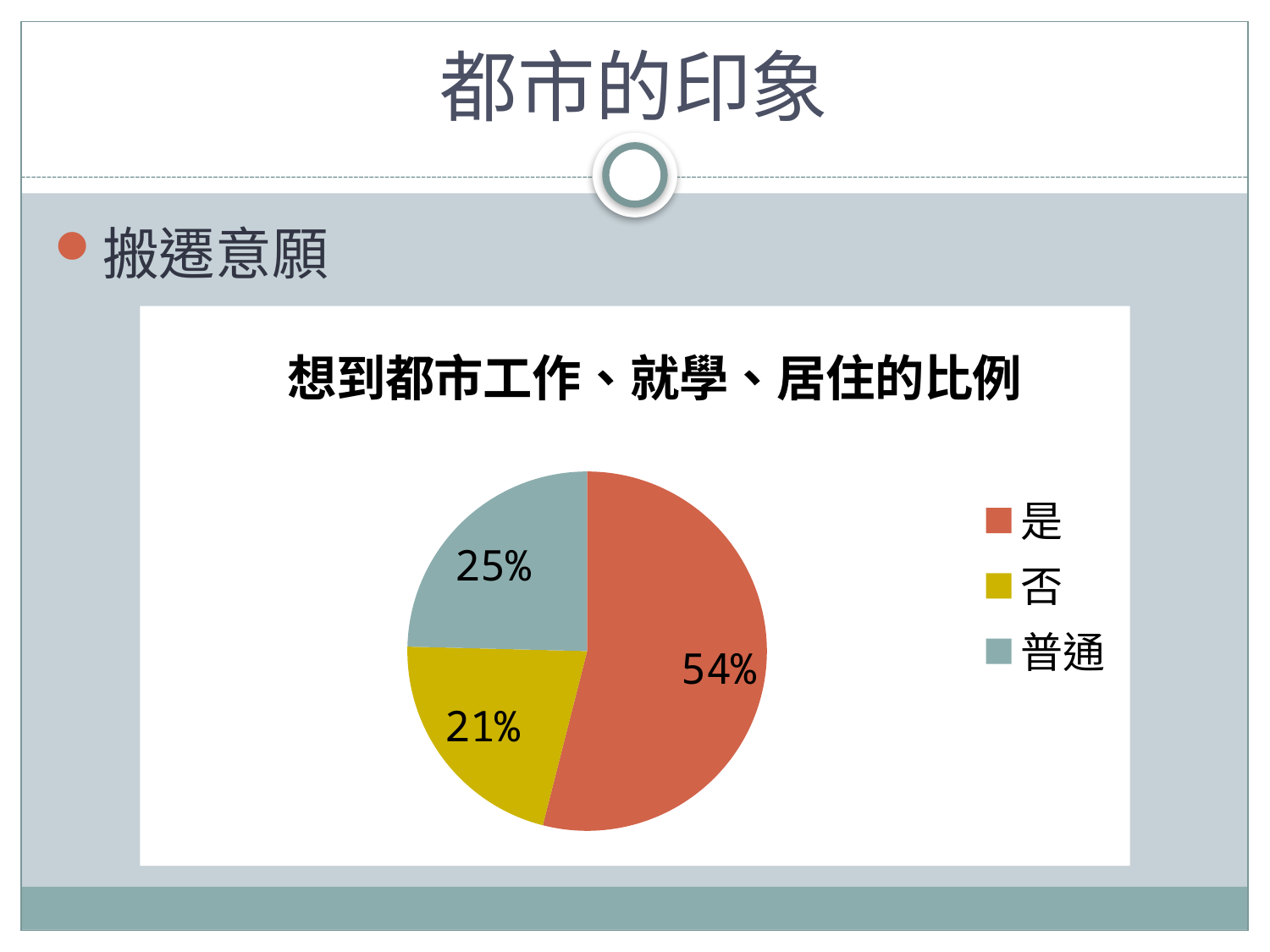
How many categories does the pie chart have? 3 What percentage of the pie is the 普通 slice? 25% What is the difference in percentage points between the 普通 slice and the 否 slice? 4 Which category has the largest share of the pie? 是 What colour is the 是 slice in the pie chart? red Which category has the smallest share of the pie? 否 Which slice is larger, 否 or 普通? 普通 What percentage of the pie is the 否 slice? 21% What is the difference in percentage points between the 是 slice and the 普通 slice? 29 What type of chart is shown on the slide? pie chart What percentage of the pie is the 是 slice? 54% What is the title of the chart? 想到都市工作、就學、居住的比例